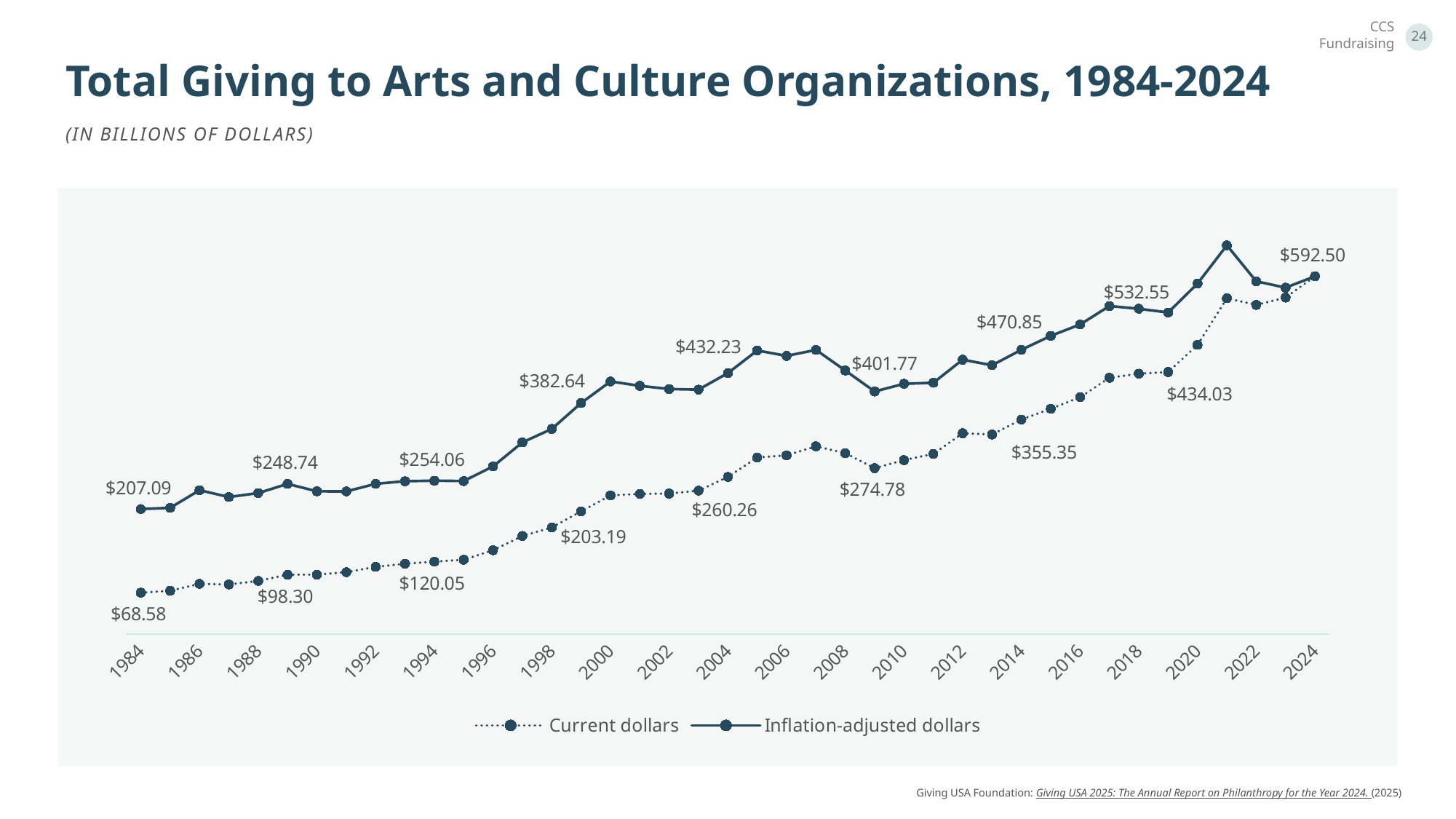
What is the current dollars value for 2019? $434.03 What type of chart is shown on the slide? Line chart What is the inflation-adjusted dollars value for 1984? $207.09 What is the current dollars value for 1984? $68.58 Overall, do the current dollars values rise or fall from 1984 to 2024? Rise What is the difference between the inflation-adjusted and current dollars values in 2019? $98.52 What is the inflation-adjusted dollars value for 2009? $401.77 What is the difference between the inflation-adjusted and current dollars values in 1984? $138.51 What is the value shown for 2024? $592.50 Which year has the highest inflation-adjusted dollars value? 2021 How many series does the legend list? 2 Which year has the lowest current dollars value? 1984